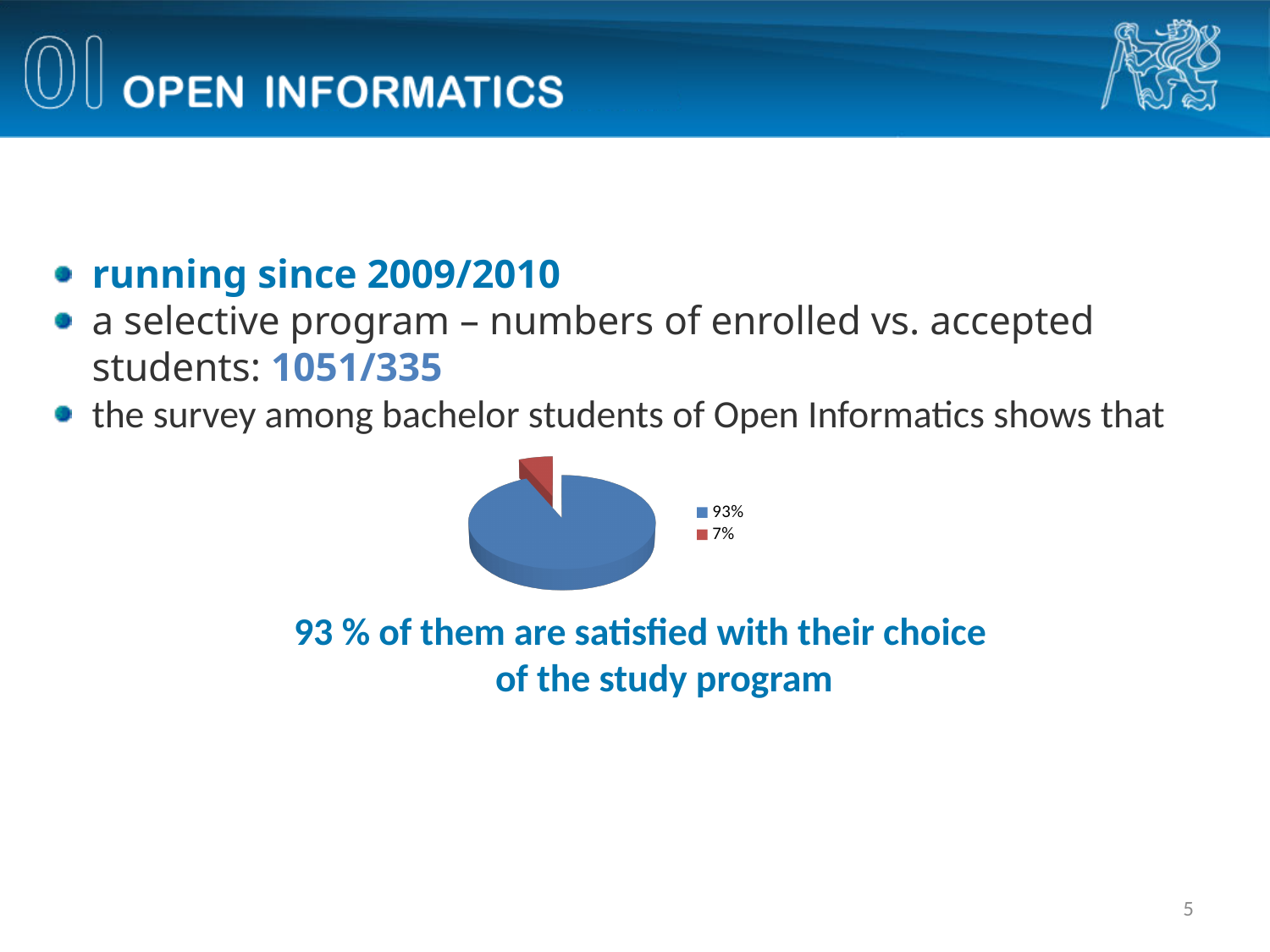
What share of the pie does the blue slice represent? 93% What are the two entries listed in the pie chart's legend? 93% and 7% What colour is the slice labelled 7% in the legend? red Which is larger, the blue slice or the red slice? the blue slice How many entries does the legend of the pie chart list? 2 Which slice of the pie chart is the largest? the blue slice (93%) What is the total of the two slices shown in the pie chart? 100% Which slice of the pie chart is the smallest? the red slice (7%) What share of the pie does the red slice represent? 7% By how many percentage points does the 93% slice exceed the 7% slice? 86 percentage points How many slices does the pie chart have? 2 What kind of chart is shown on the slide? pie chart